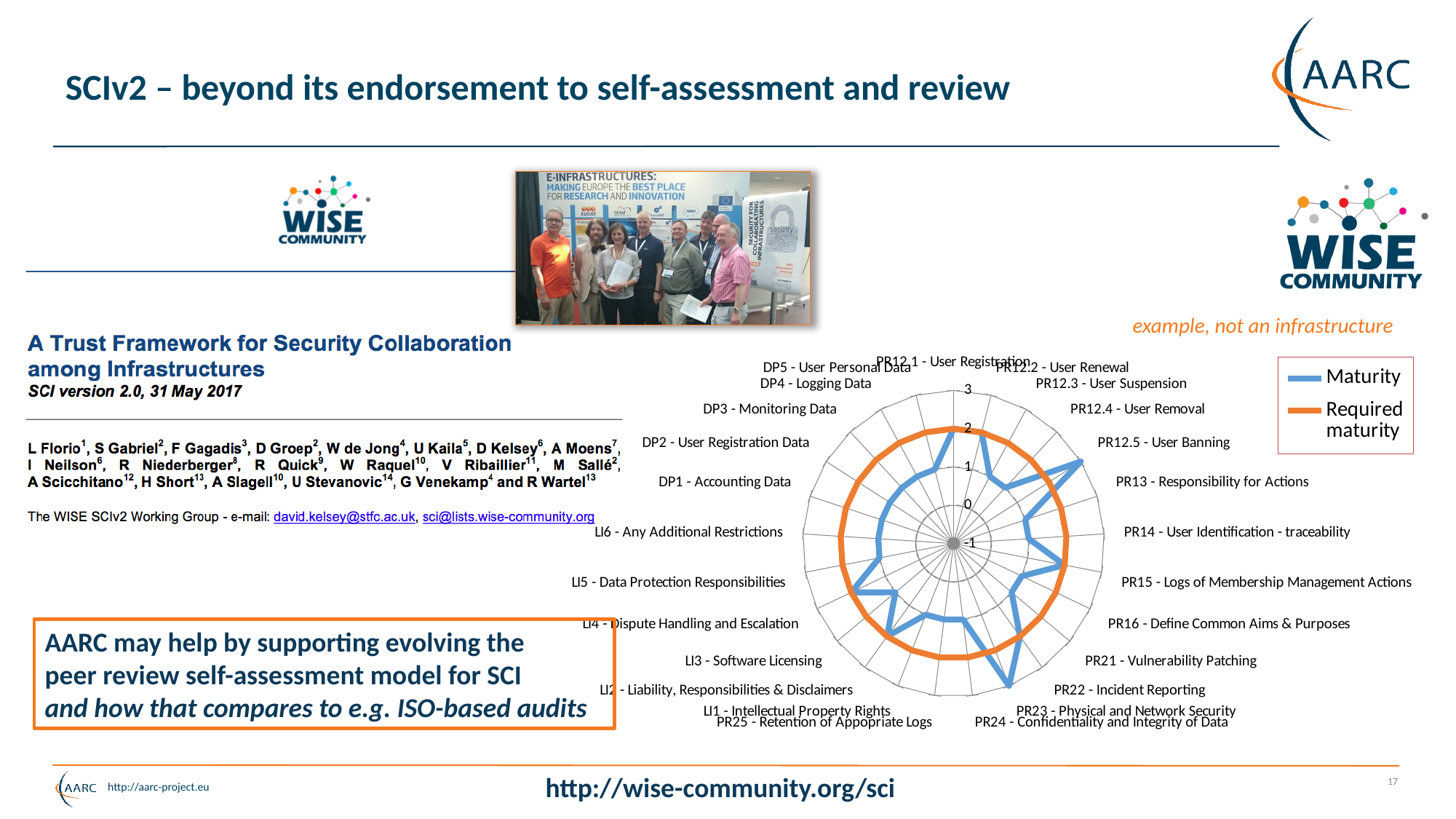
Is the Maturity value for PR12.5 - User Banning greater or less than 2? greater Is the Maturity value for DP1 - Accounting Data greater or less than 2? less What is the highest tick value shown on the radar chart's scale? 3 What kind of chart is shown on the slide? Radar chart How many series does the chart legend list? 2 How many categories (axes) does the radar chart have? 25 For DP1 - Accounting Data, which is larger: the Maturity value or the Required maturity value? Required maturity What are the two series named in the chart legend? Maturity and Required maturity Is the Maturity value for LI6 - Any Additional Restrictions greater or less than 2? less What is the Required maturity value shown for every category on the chart? 2 For PR12.5 - User Banning, which is larger: the Maturity value or the Required maturity value? Maturity